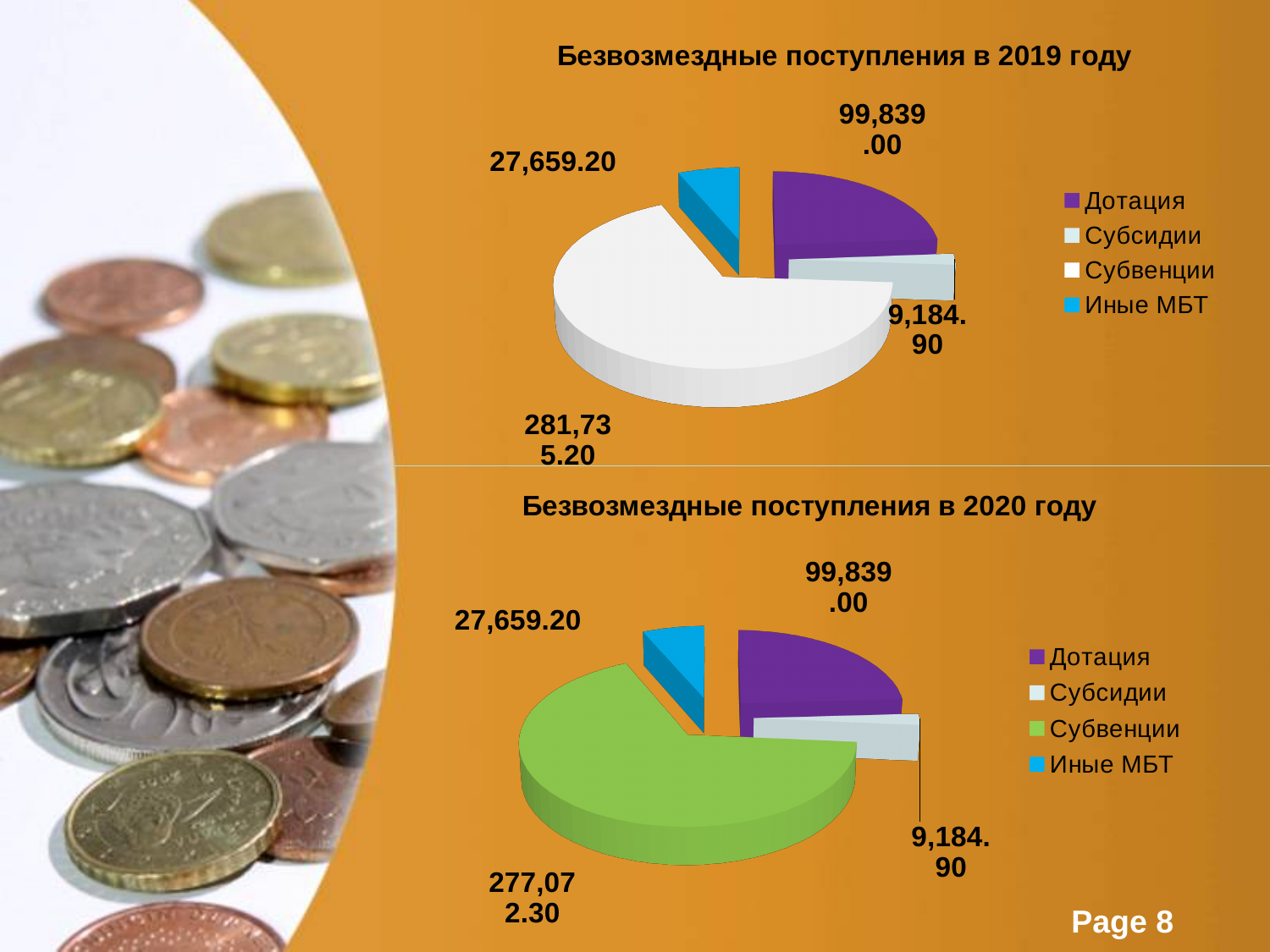
In the 2020 chart, which category has the smallest value? Субсидии What type of chart is used for 'Безвозмездные поступления в 2019 году'? pie chart In the 2019 chart, which category has the largest value? Субвенции In the 2020 chart, what is the value for Иные МБТ? 27,659.20 In the 2020 chart, what is the value for Субвенции? 277,072.30 What is the difference between the Субвенции value in the 2019 chart and the Субвенции value in the 2020 chart? 4,662.90 In the 2019 chart, which is larger: Дотация or Иные МБТ? Дотация In the 2019 chart, what is the value for Дотация? 99,839.00 How many categories does the legend of the 2020 chart list? 4 In the 2019 chart, what is the value for Субвенции? 281,735.20 In the 2020 chart, what is the value for Субсидии? 9,184.90 In the 2020 chart, what colour is the Субвенции slice? green